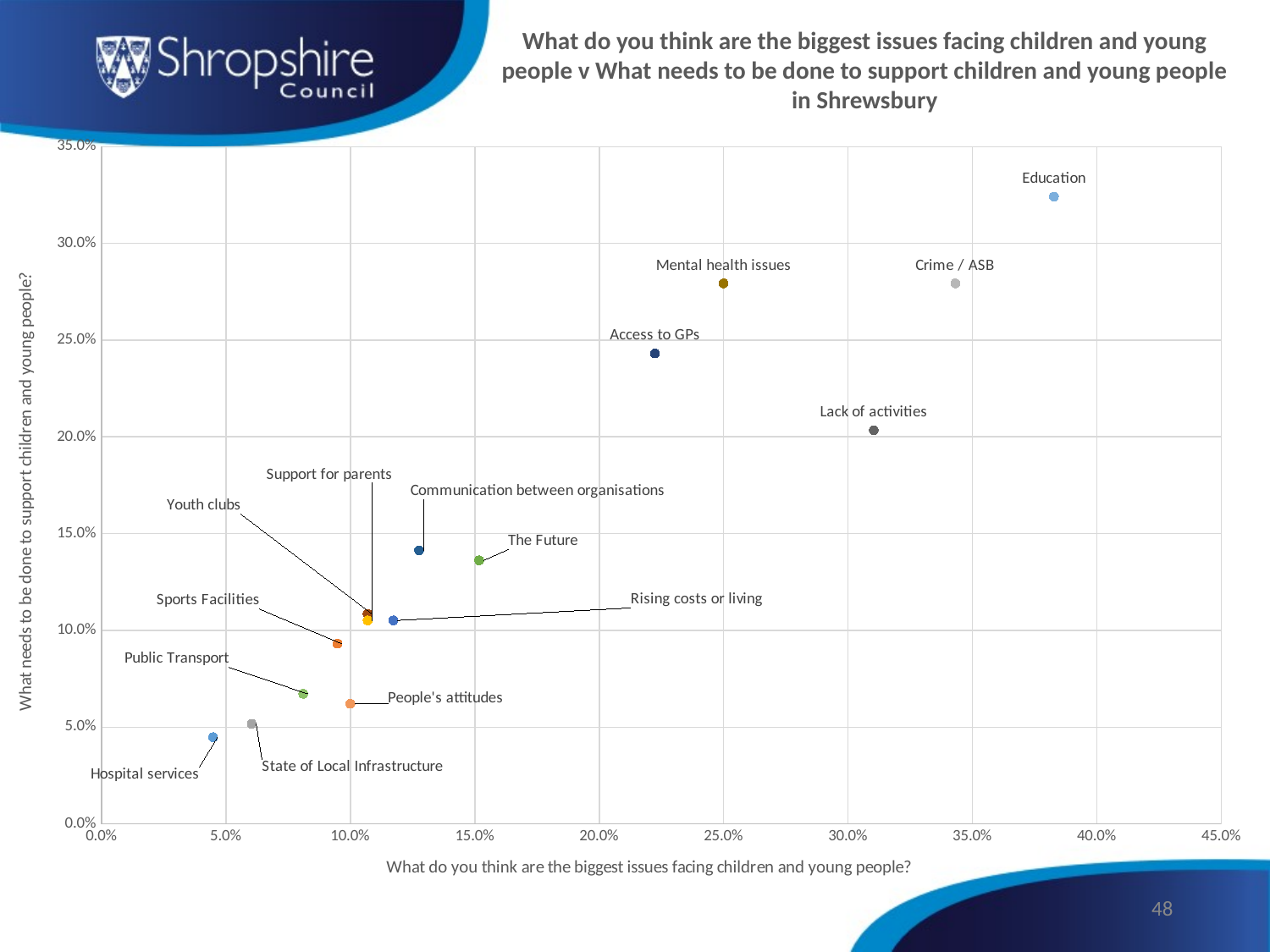
Is the horizontal-axis value for Mental health issues greater or less than 20.0%? greater Is the vertical-axis value for Education greater or less than 30.0%? greater Which has the larger horizontal-axis value, Access to GPs or Lack of activities? Lack of activities Which issue has the highest value on the vertical axis (What needs to be done to support children and young people)? Education Is the vertical-axis value for Hospital services greater or less than 5.0%? less How many labelled data points are plotted on the chart? 15 What is the title of the horizontal axis? What do you think are the biggest issues facing children and young people? Which has the higher vertical-axis value, Crime / ASB or Lack of activities? Crime / ASB Which issue has the highest value on the horizontal axis (What do you think are the biggest issues facing children and young people)? Education Which issue has the lowest value on the vertical axis? Hospital services What kind of chart is shown on the slide? scatter chart